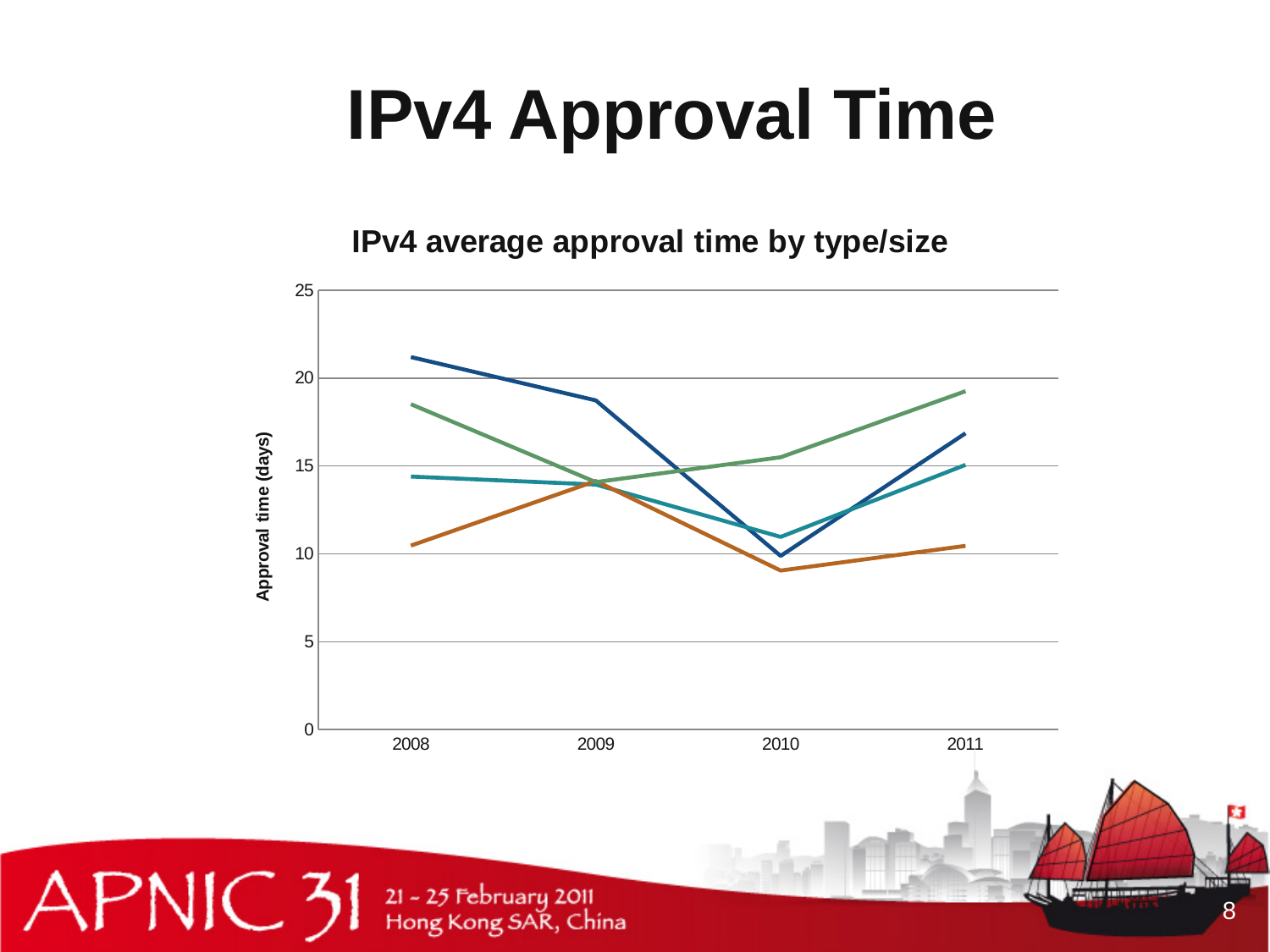
Is the value of the orange line in 2010 greater or less than 10? less Does the dark blue line rise or fall from 2008 to 2010? fall How many years are shown along the x axis of the chart? 4 Which line has the lowest value in 2008? the orange line Is the value of the green line in 2011 greater or less than 20? less Which line has the highest value in 2011? the green line Is the value of the dark blue line in 2009 greater or less than 20? less What kind of chart is shown on the slide? line chart What is the label on the vertical axis of the chart? Approval time (days) How many lines are plotted on the chart? 4 What is the title of the chart? IPv4 average approval time by type/size